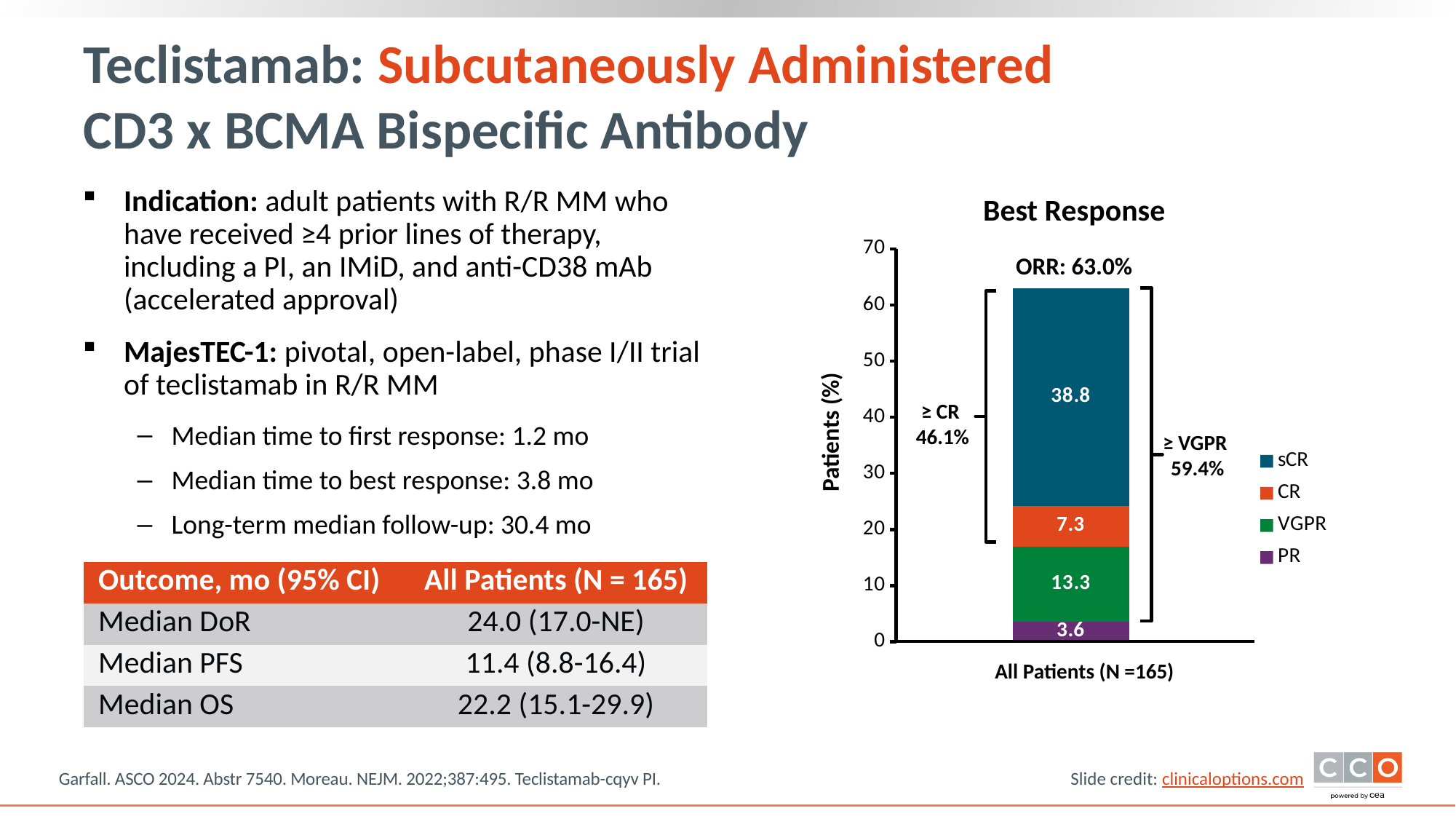
What is the value for sCR in the Best Response chart? 38.8 What is the difference between the sCR and VGPR values? 25.5 How many series does the chart legend list? 4 What is the value for VGPR in the Best Response chart? 13.3 What is the title of the chart? Best Response Which response category has the smallest segment in the stacked bar? PR What is the ORR shown above the stacked bar? 63.0% What is the value for CR in the Best Response chart? 7.3 Which response category has the largest segment in the stacked bar? sCR What type of chart is shown on the slide? Stacked bar chart Which is larger, the CR value or the VGPR value? VGPR What is the value for PR in the Best Response chart? 3.6